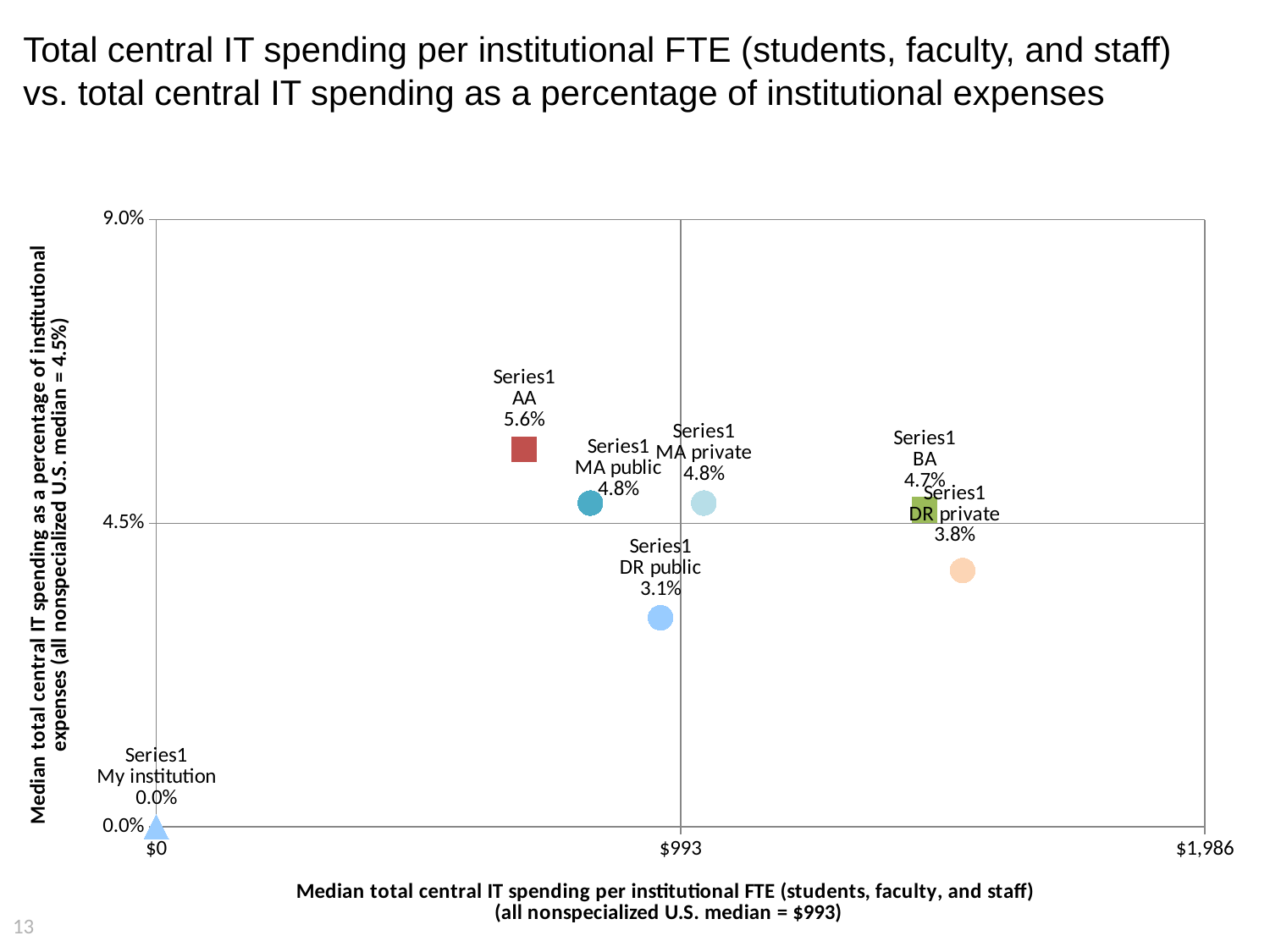
How many labeled data points are plotted on the chart? 7 What kind of chart is shown on the slide? scatter chart Is the median total central IT spending per institutional FTE for DR private greater or less than $993? greater Excluding My institution, which labeled point has the lowest percentage of institutional expenses? DR public Which labeled point has the highest percentage of institutional expenses? AA What is the difference between the percentage for AA and the percentage for DR public? 2.5% What percentage value is labeled for DR private? 3.8% Is the median total central IT spending per institutional FTE for AA greater or less than $993? less What percentage value is labeled for BA? 4.7% What is the median total central IT spending as a percentage of institutional expenses for AA institutions? 5.6% What percentage value is labeled for DR public? 3.1% Which has a higher percentage of institutional expenses, BA or DR private? BA